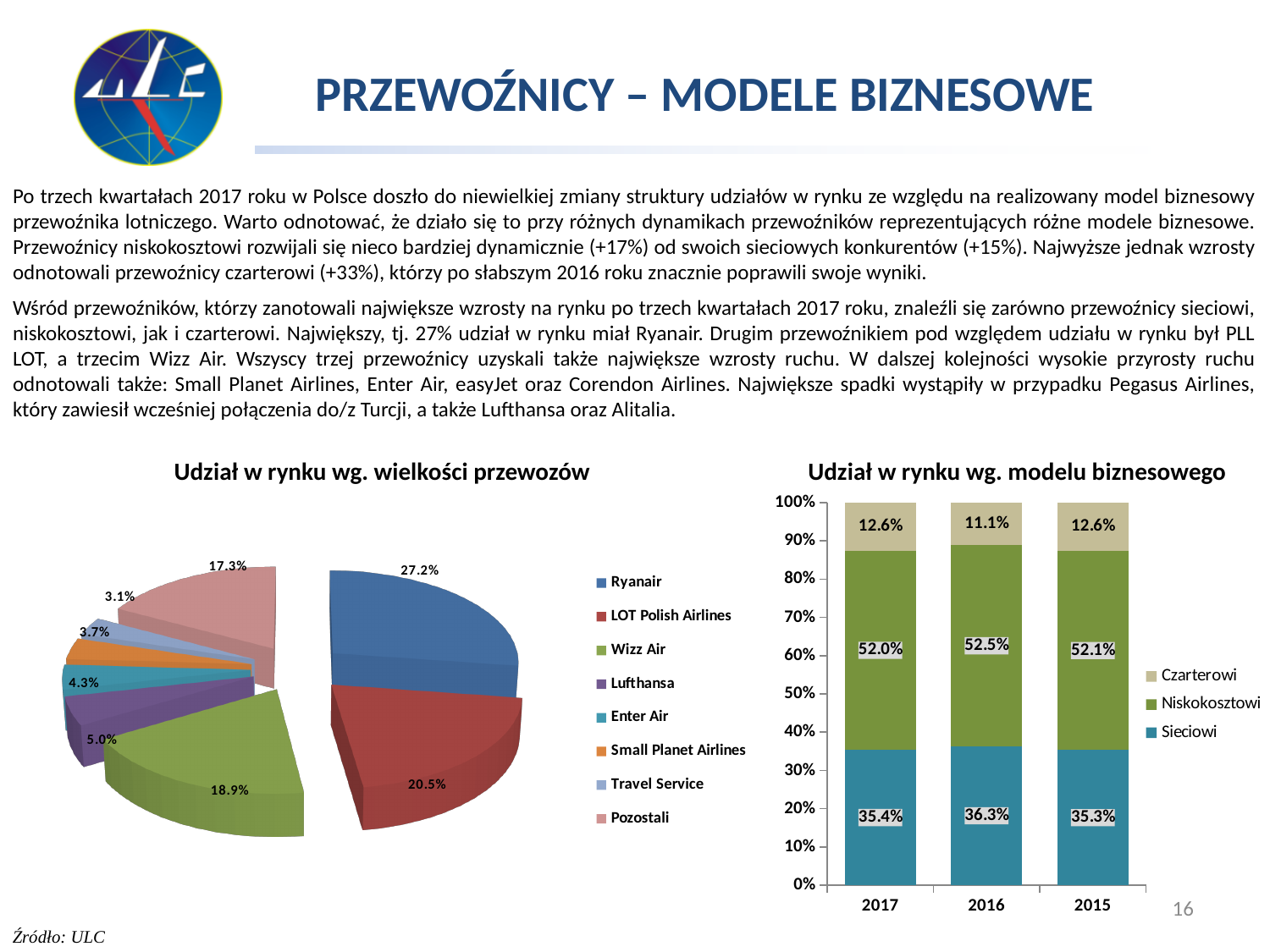
In the chart 'Udział w rynku wg. wielkości przewozów', how many entries does the legend list? 8 In the chart 'Udział w rynku wg. wielkości przewozów', what is the difference between the shares of Ryanair and LOT Polish Airlines? 6.7% In the chart 'Udział w rynku wg. modelu biznesowego', is the value for Sieciowi in 2017 larger or smaller than the value for Sieciowi in 2016? Smaller In the chart 'Udział w rynku wg. modelu biznesowego', what is the value for Czarterowi in 2017? 12.6% What type of chart is 'Udział w rynku wg. modelu biznesowego'? Stacked bar chart In the chart 'Udział w rynku wg. modelu biznesowego', what is the value for Niskokosztowi in 2016? 52.5% What type of chart is 'Udział w rynku wg. wielkości przewozów'? Pie chart In the chart 'Udział w rynku wg. wielkości przewozów', what share does Ryanair have? 27.2% In the chart 'Udział w rynku wg. modelu biznesowego', how many years are shown on the x axis? 3 In the chart 'Udział w rynku wg. wielkości przewozów', which carrier has the smallest share? Travel Service In the chart 'Udział w rynku wg. modelu biznesowego', which year has the highest value for Sieciowi? 2016 In the chart 'Udział w rynku wg. wielkości przewozów', what share does Wizz Air have? 18.9%